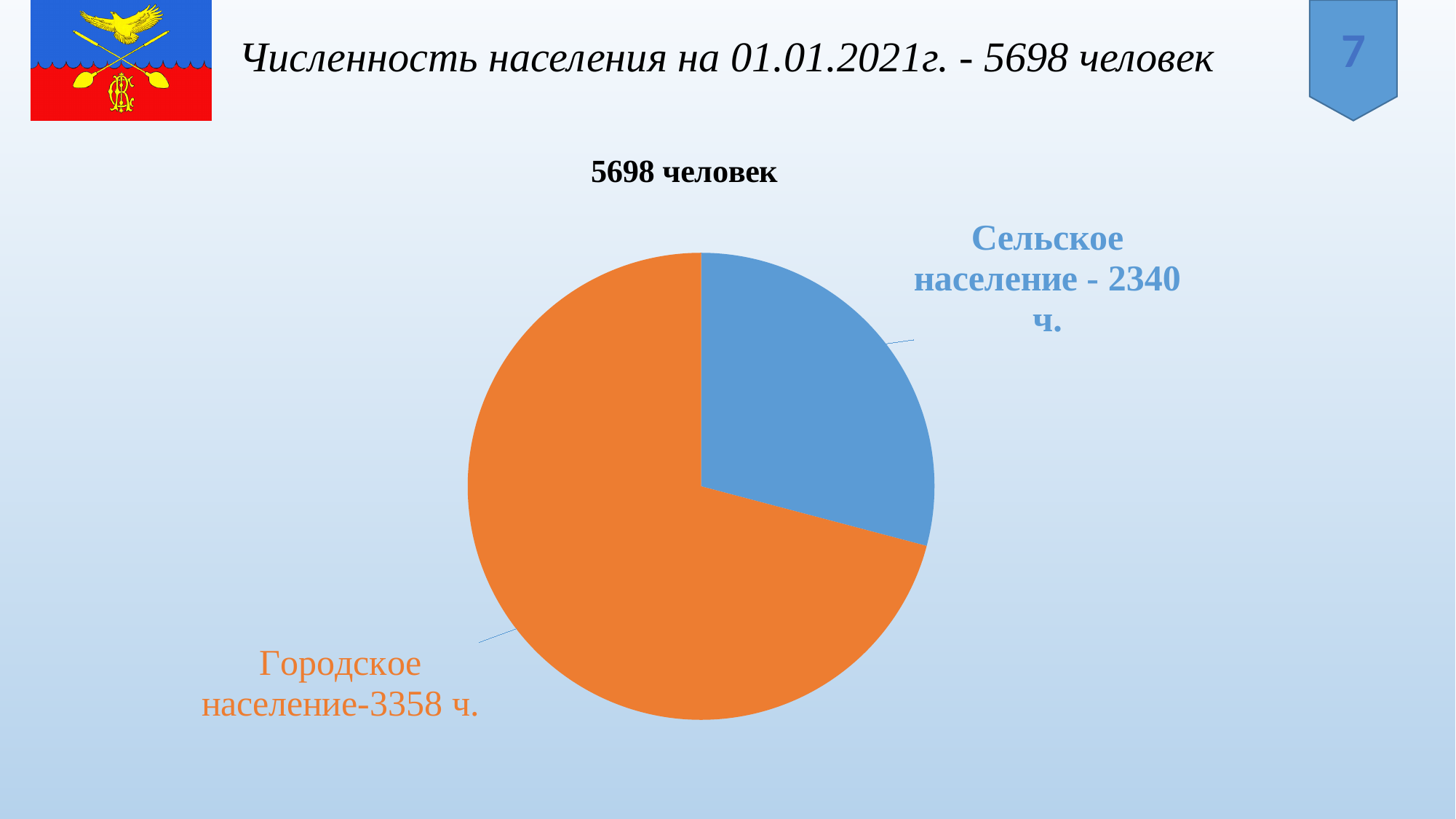
What is the difference between Городское население and Сельское население? 1018 What kind of chart is shown on the slide? Pie chart What is the title of the chart? 5698 человек Which is larger, Городское население or Сельское население? Городское население What is the total of the two slices in the pie chart? 5698 What is the value shown for Городское население? 3358 ч. How many slices does the pie chart have? 2 Which slice of the pie chart is the largest? Городское население What is the value shown for Сельское население? 2340 ч. Which slice of the pie chart is the smallest? Сельское население